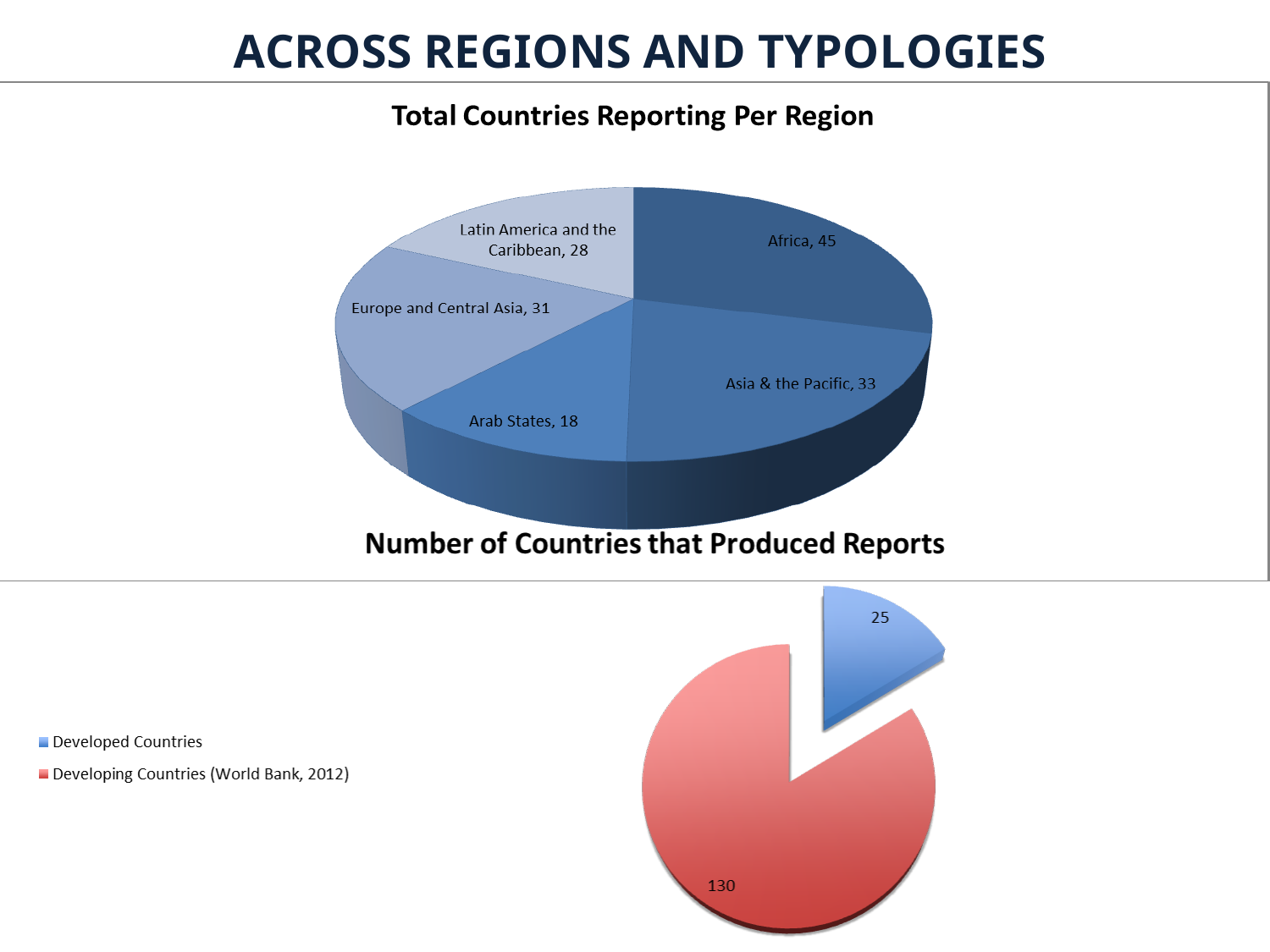
In the 'Total Countries Reporting Per Region' chart, which region has the largest slice? Africa In the 'Total Countries Reporting Per Region' chart, what is the value for Arab States? 18 In the 'Total Countries Reporting Per Region' chart, what is the difference between Africa and Latin America and the Caribbean? 17 In the 'Total Countries Reporting Per Region' chart, which is larger: Asia & the Pacific or Europe and Central Asia? Asia & the Pacific In the 'Total Countries Reporting Per Region' chart, which region has the smallest slice? Arab States What type of chart is 'Total Countries Reporting Per Region'? Pie chart In the 'Total Countries Reporting Per Region' chart, how many countries reported from Africa? 45 How many regions are shown in the 'Total Countries Reporting Per Region' chart? 5 In the 'Total Countries Reporting Per Region' chart, what is the value for Europe and Central Asia? 31 In the 'Number of Countries that Produced Reports' chart, what is the difference between Developing Countries and Developed Countries? 105 How many series does the legend of the 'Number of Countries that Produced Reports' chart list? 2 In the 'Number of Countries that Produced Reports' chart, what is the value for Developing Countries (World Bank, 2012)? 130